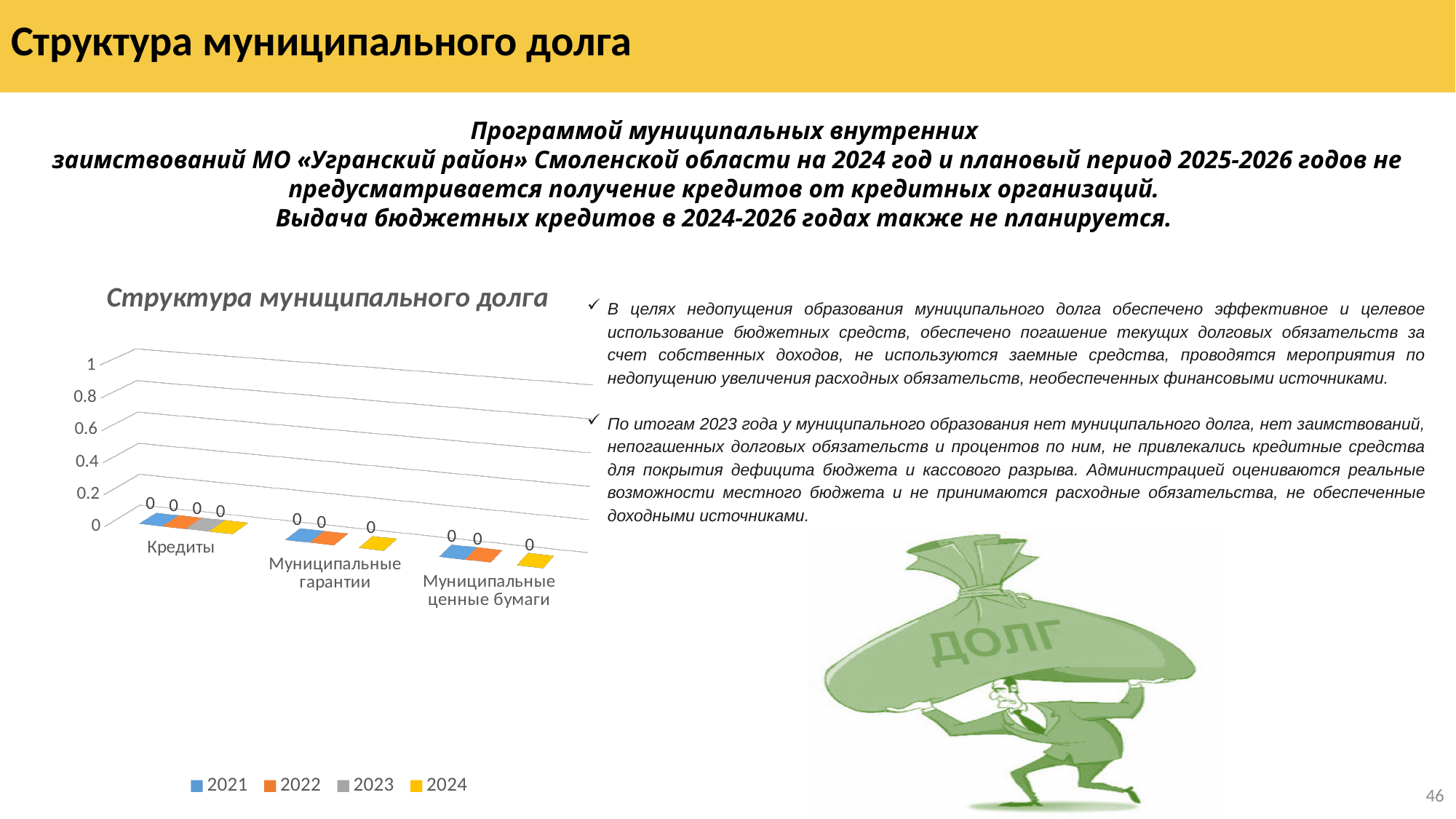
What is the title of the chart on the slide? Структура муниципального долга How many categories are shown on the x axis of the chart? 3 What is the value for Кредиты in 2021? 0 What is the difference between the 2021 and 2024 values for Кредиты? 0 What is the highest tick value shown on the vertical axis of the chart? 1 How many series does the chart legend list? 4 What is the value for Муниципальные ценные бумаги in 2024? 0 Is the value for Муниципальные гарантии in 2024 greater or less than 0.2? less What is the value for Муниципальные гарантии in 2022? 0 What is the value for Кредиты in 2024? 0 Which series are listed in the chart legend? 2021, 2022, 2023, 2024 What kind of chart is shown on the slide? bar chart